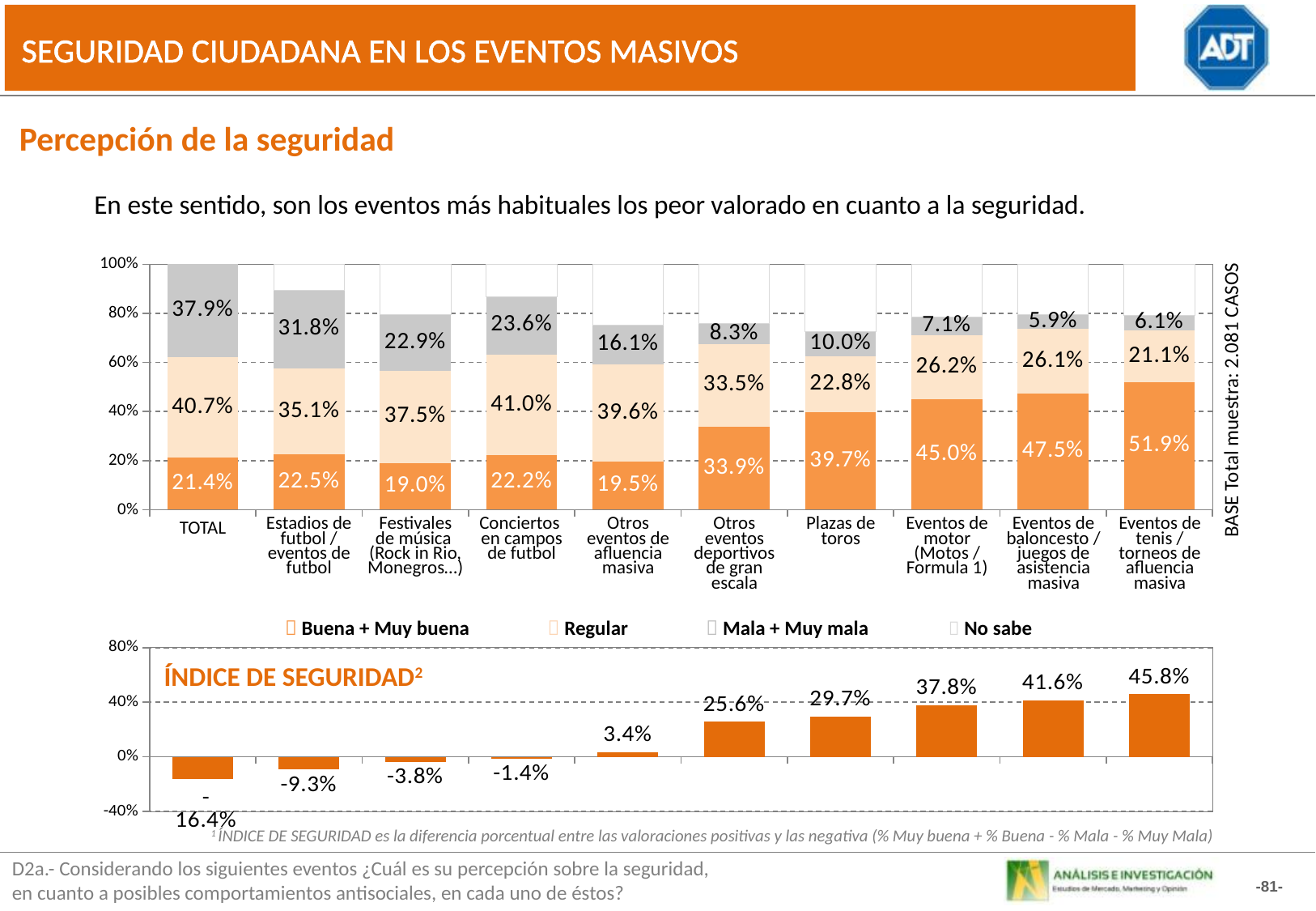
In the ÍNDICE DE SEGURIDAD chart, what is the highest value shown? 45.8% In the top stacked bar chart, what is the difference between the 'Buena + Muy buena' values for Plazas de toros and Otros eventos deportivos de gran escala? 5.8% What kind of chart is the ÍNDICE DE SEGURIDAD chart? Bar chart How many series does the legend of the top stacked bar chart list? 4 In the ÍNDICE DE SEGURIDAD chart, what is the value for the first bar (TOTAL)? -16.4% How many categories are shown on the x axis of the top stacked bar chart? 10 In the top stacked bar chart, what is the 'Buena + Muy buena' value for TOTAL? 21.4% In the top stacked bar chart, which category has the highest 'Buena + Muy buena' value? Eventos de tenis / torneos de afluencia masiva In the top stacked bar chart, which category has the lowest 'Buena + Muy buena' value? Festivales de música (Rock in Rio, Monegros…) In the top stacked bar chart, what is the 'Mala + Muy mala' value for Estadios de futbol / eventos de futbol? 31.8% In the top stacked bar chart, which is larger: the 'Mala + Muy mala' value for Festivales de música or for Conciertos en campos de futbol? Conciertos en campos de futbol In the top stacked bar chart, what is the 'Regular' value for Conciertos en campos de futbol? 41.0%